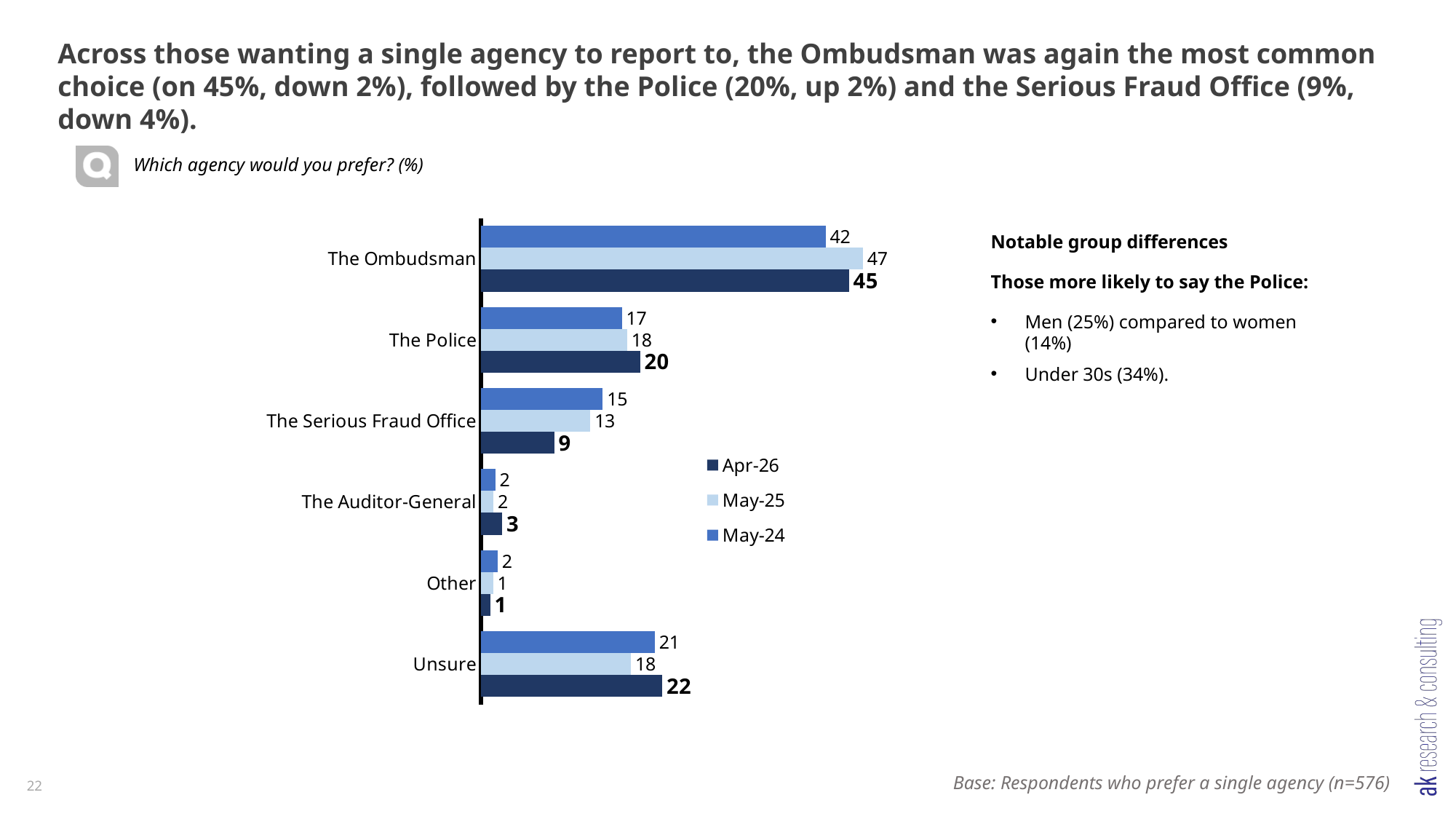
Which series is shown in the darkest blue colour in the legend? Apr-26 How many series does the legend list? 3 What is the Apr-26 value for The Ombudsman? 45 Does the value for The Serious Fraud Office rise or fall from May-24 to Apr-26? Fall Which category has the highest Apr-26 value? The Ombudsman How many categories are shown on the chart? 6 What is the May-24 value for Unsure? 21 What is the May-25 value for The Serious Fraud Office? 13 What is the difference between the May-25 and Apr-26 values for The Ombudsman? 2 Which category has the lowest May-25 value? Other Which is larger for The Police: the May-24 value or the Apr-26 value? Apr-26 What kind of chart is shown on the slide? Bar chart